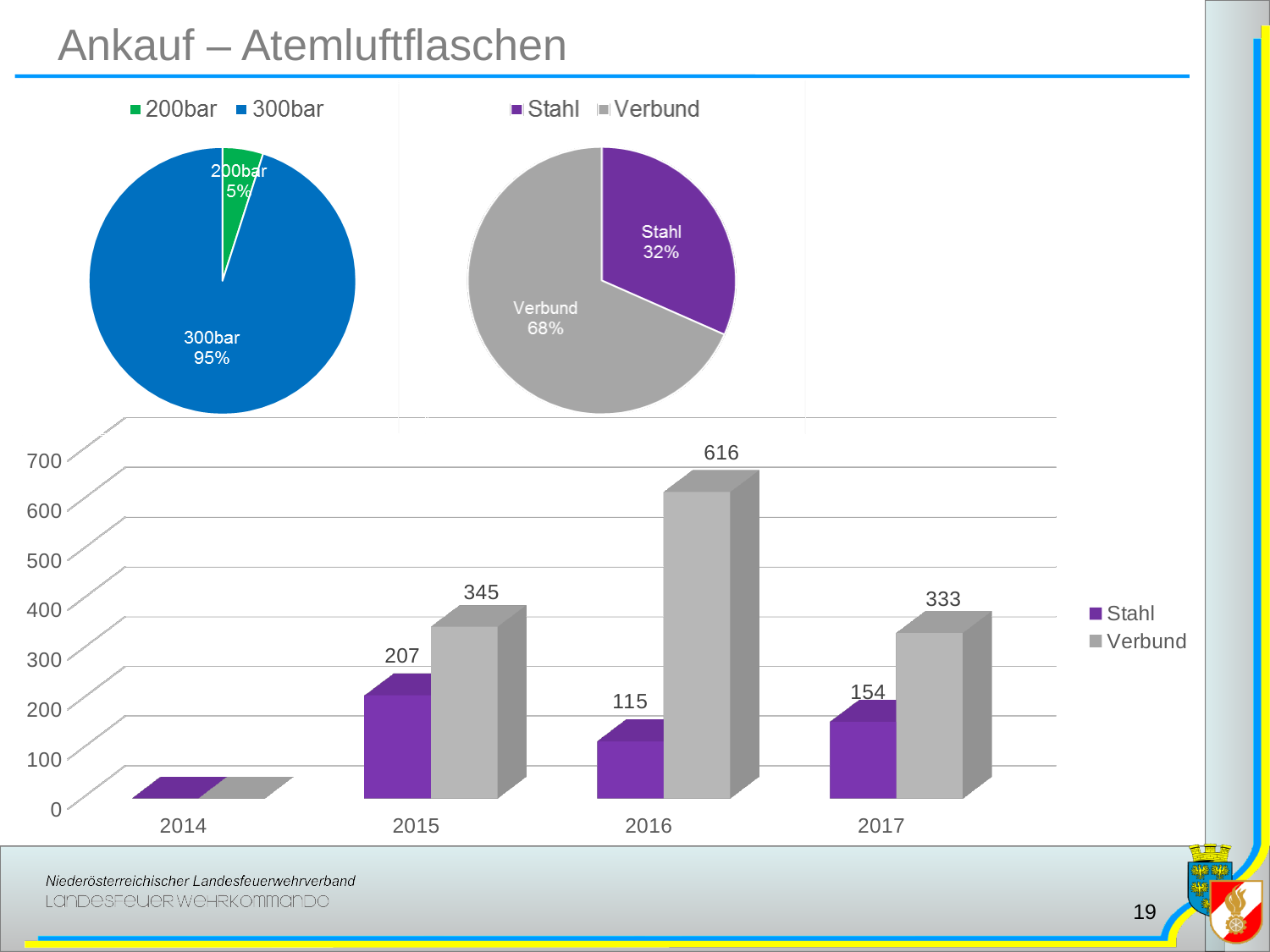
In the bottom bar chart, which year has the highest Verbund value? 2016 In the bottom bar chart, which year has the lowest Stahl value? 2014 In the right pie chart, what share does Stahl have? 32% In the left pie chart, what share does 300bar have? 95% In the bottom bar chart, what is the value for Verbund in 2016? 616 In the bottom bar chart, what is the value for Stahl in 2015? 207 In the bottom bar chart, what is the difference between Verbund and Stahl in 2016? 501 In the bottom bar chart, which is larger in 2017: Stahl or Verbund? Verbund In the bottom bar chart, how many years are shown on the x axis? 4 What kind of chart is the chart at the bottom of the slide? bar chart In the bottom bar chart, what is the value for Verbund in 2017? 333 In the bottom bar chart, how many series does the legend list? 2